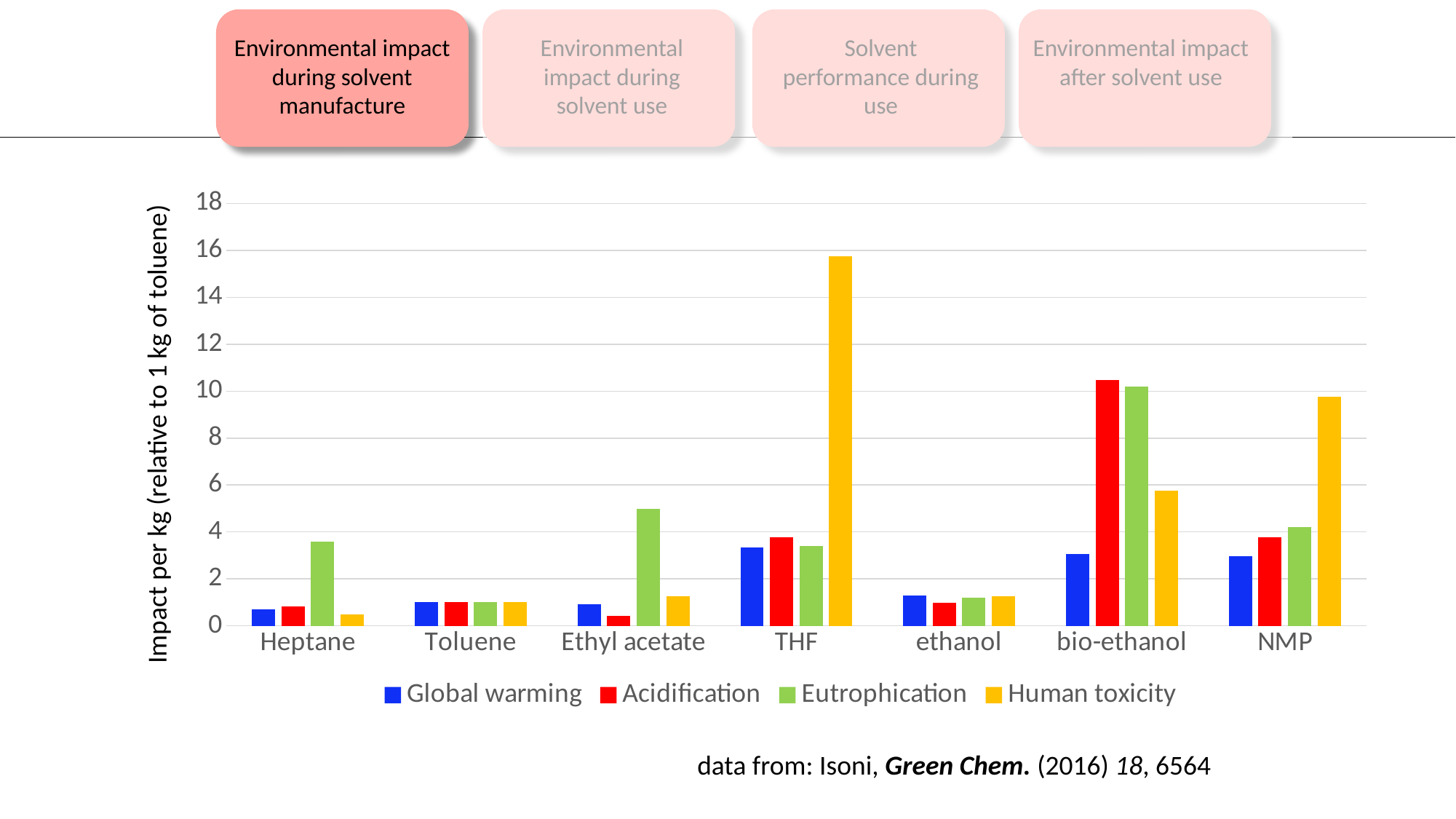
What kind of chart is shown on the slide? bar chart Which is larger for Ethyl acetate: the Eutrophication value or the Human toxicity value? Eutrophication Which colour represents Human toxicity in the chart legend? yellow Which solvent has the highest Human toxicity bar? THF Which solvent has the lowest Acidification bar? Ethyl acetate How many solvents are shown on the x axis of the chart? 7 What is the label on the y axis of the chart? Impact per kg (relative to 1 kg of toluene) How many series does the chart legend list? 4 Is the Eutrophication value for bio-ethanol greater or less than 8? greater Is the Human toxicity value for NMP greater or less than 8? greater Is the Human toxicity value for THF greater or less than 14? greater Which solvent has the highest Acidification bar? bio-ethanol